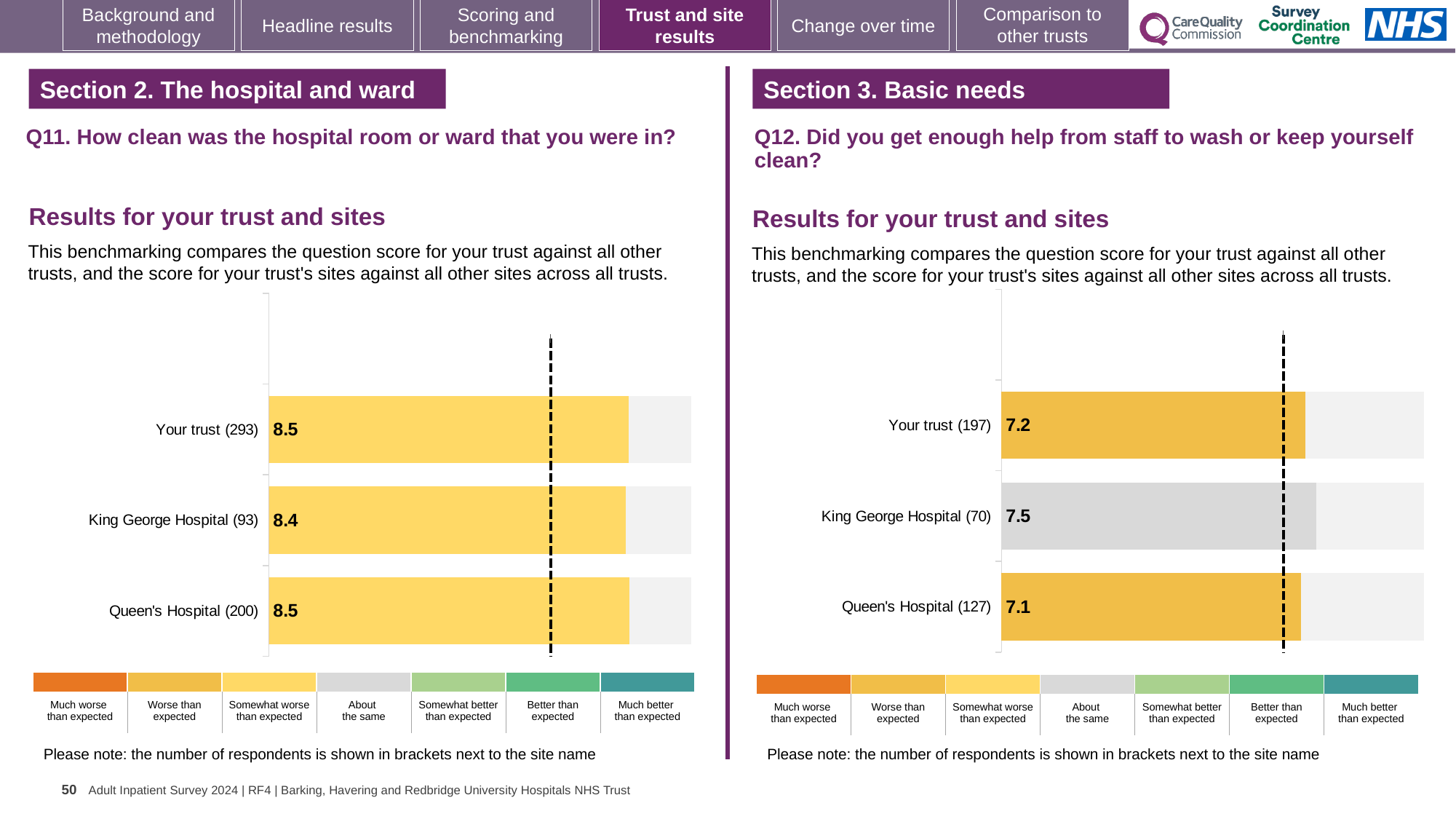
In the Q12 chart on the right, which site or trust has the lowest score? Queen's Hospital In the Q11 chart on the left, what is the score for Your trust? 8.5 In the Q12 chart on the right, which site or trust has the highest score? King George Hospital In the Q12 chart on the right, what is the score for King George Hospital? 7.5 In the Q12 chart on the right, what is the difference between the King George Hospital score and the Queen's Hospital score? 0.4 How many bars are plotted in the Q11 chart on the left? 3 In the Q11 chart on the left, which has the lowest score? King George Hospital In the Q12 chart on the right, what is the score for Queen's Hospital? 7.1 In the Q11 chart on the left, what is the score for King George Hospital? 8.4 In the Q12 chart on the right, which is larger: the score for Your trust or the score for King George Hospital? King George Hospital What type of chart is used for the Q12 results on the right? Bar chart In the Q11 chart on the left, what is the difference between the Your trust score and the King George Hospital score? 0.1